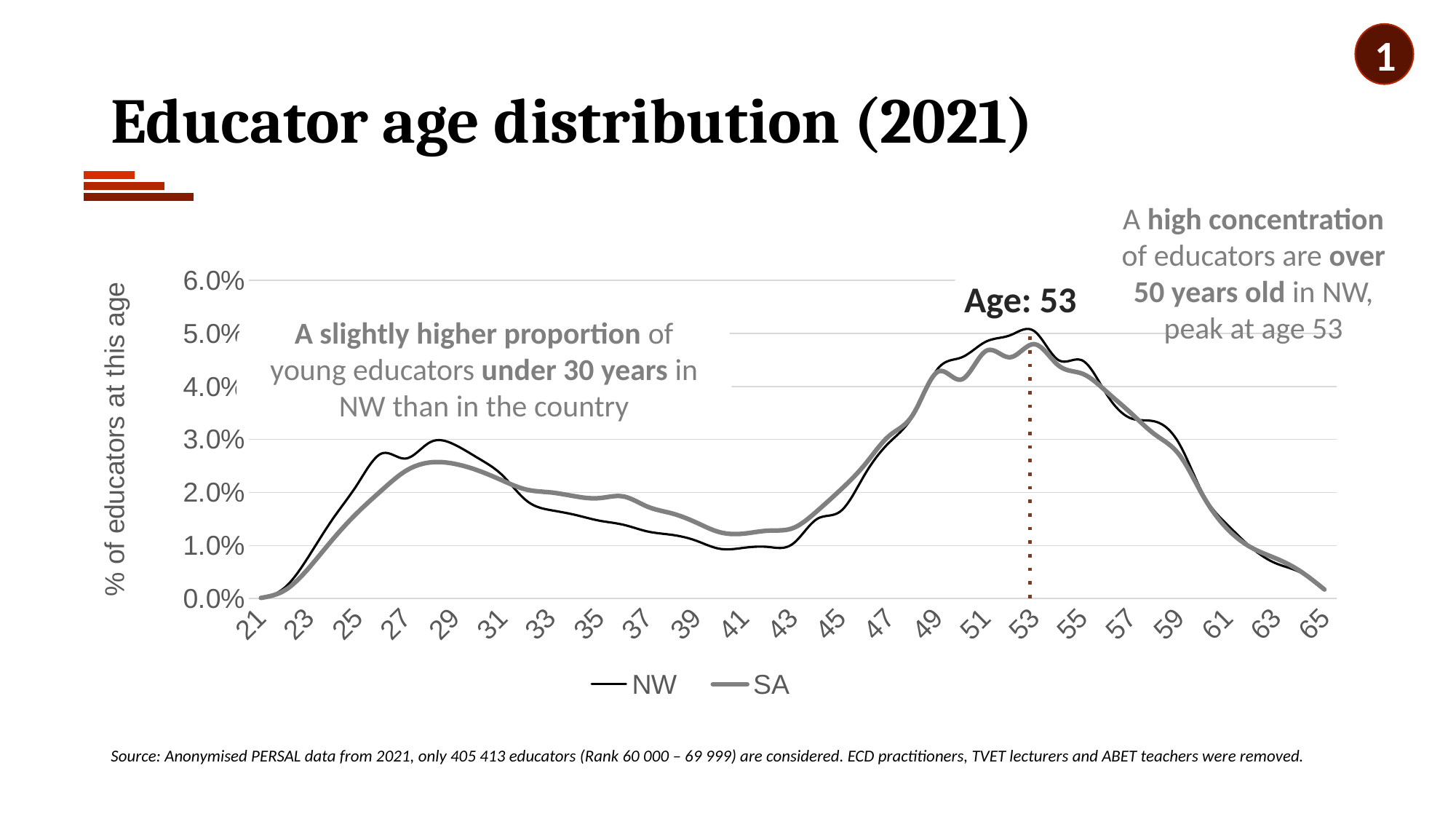
Is the SA value at age 53 greater or less than 4.0%? greater What kind of chart is shown on the slide? Line chart How many series does the legend list? 2 At which age is the NW series at its lowest value? 21 Is the NW value at age 29 greater or less than 2.0%? greater What are the two series named in the legend? NW and SA Is the NW value at age 65 greater or less than 1.0%? less What is the title of the chart's vertical axis? % of educators at this age At which age does the NW series reach its highest value? 53 At age 29, which series has the higher value, NW or SA? NW At age 35, which series has the higher value, NW or SA? SA